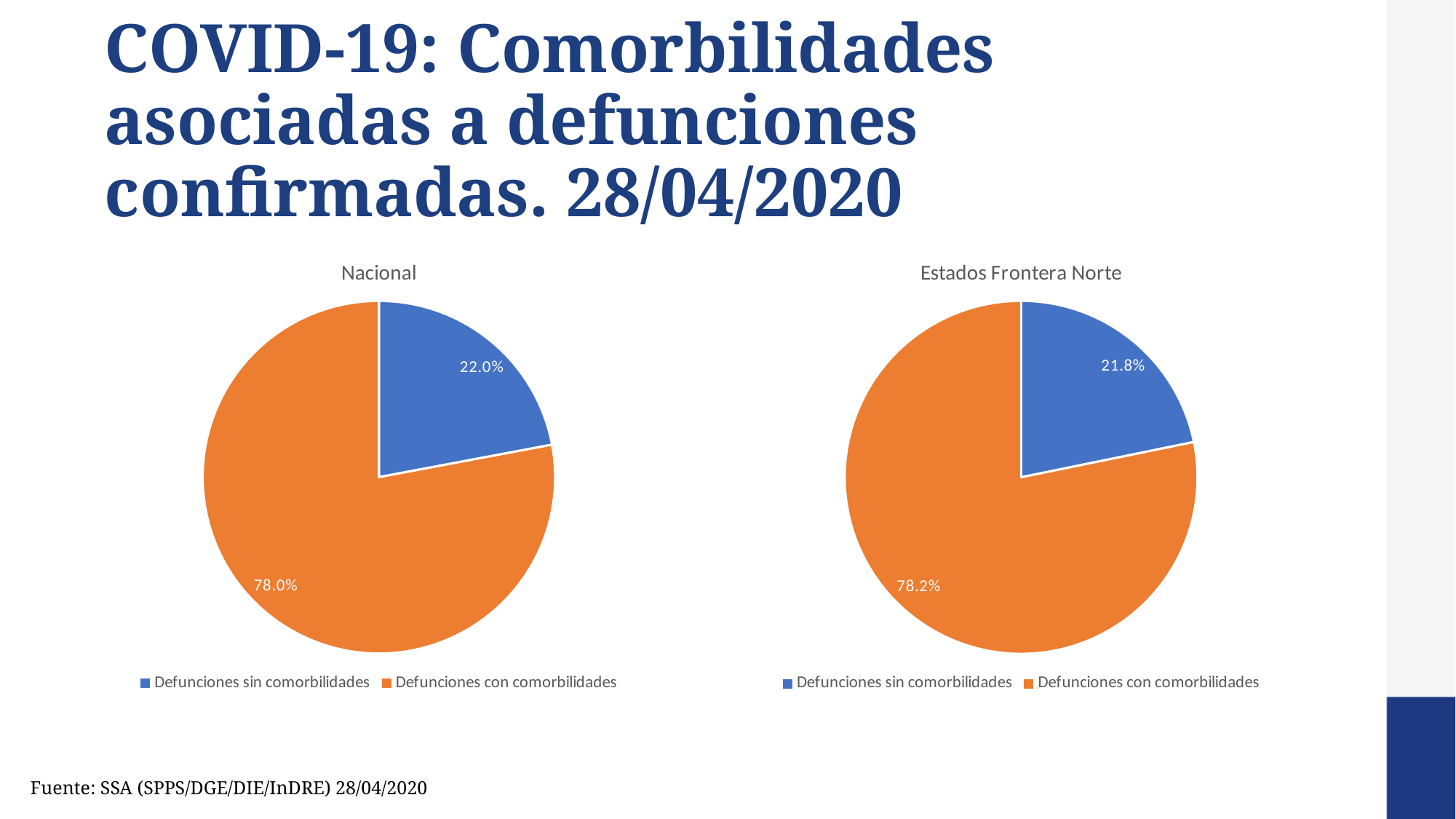
In the 'Estados Frontera Norte' chart, what share of deaths is 'Defunciones con comorbilidades'? 78.2% In the 'Estados Frontera Norte' chart, which category has the smallest slice? Defunciones sin comorbilidades In the 'Nacional' chart, what is the difference in percentage points between 'Defunciones con comorbilidades' and 'Defunciones sin comorbilidades'? 56.0 percentage points What type of chart is the 'Nacional' chart? Pie chart How many entries does the legend of the 'Nacional' chart list? 2 In the 'Nacional' chart, what share of deaths is 'Defunciones con comorbilidades'? 78.0% In the 'Estados Frontera Norte' chart, what share of deaths is 'Defunciones sin comorbilidades'? 21.8% Which chart shows a larger share for 'Defunciones sin comorbilidades', 'Nacional' or 'Estados Frontera Norte'? Nacional In the 'Nacional' chart, what share of deaths is 'Defunciones sin comorbilidades'? 22.0% In the 'Nacional' chart, which category has the largest slice? Defunciones con comorbilidades How many slices does the 'Estados Frontera Norte' pie chart have? 2 In the 'Estados Frontera Norte' chart, what colour is the 'Defunciones con comorbilidades' slice? Orange